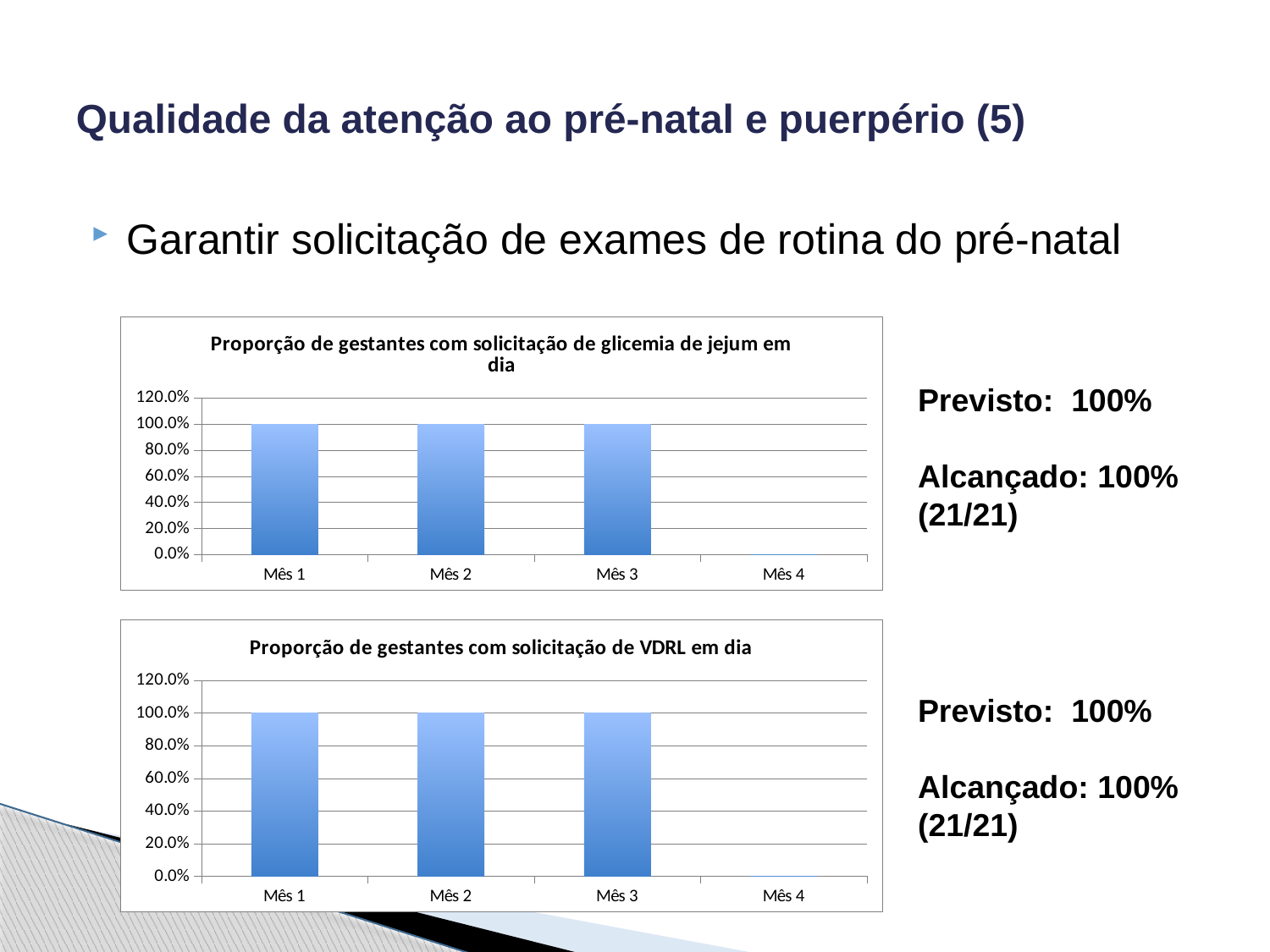
In the chart 'Proporção de gestantes com solicitação de glicemia de jejum em dia', is the value for Mês 2 greater or less than 80.0%? greater In the chart 'Proporção de gestantes com solicitação de VDRL em dia', what is the value for Mês 3? 100.0% In the chart 'Proporção de gestantes com solicitação de glicemia de jejum em dia', is the value for Mês 3 greater or less than 60.0%? greater In the chart 'Proporção de gestantes com solicitação de VDRL em dia', how many categories are shown on the x axis? 4 In the chart 'Proporção de gestantes com solicitação de VDRL em dia', which category has no bar plotted? Mês 4 In the chart 'Proporção de gestantes com solicitação de VDRL em dia', what is the highest value shown on the y axis? 120.0% In the chart 'Proporção de gestantes com solicitação de glicemia de jejum em dia', what is the difference between the values for Mês 1 and Mês 3? 0.0% In the chart 'Proporção de gestantes com solicitação de VDRL em dia', what is the value for Mês 2? 100.0% How many charts are shown on the slide? 2 In the chart 'Proporção de gestantes com solicitação de glicemia de jejum em dia', what kind of chart is shown? bar chart In the chart 'Proporção de gestantes com solicitação de VDRL em dia', do the values rise, fall or stay the same from Mês 1 to Mês 3? stay the same In the chart 'Proporção de gestantes com solicitação de glicemia de jejum em dia', what is the value for Mês 1? 100.0%